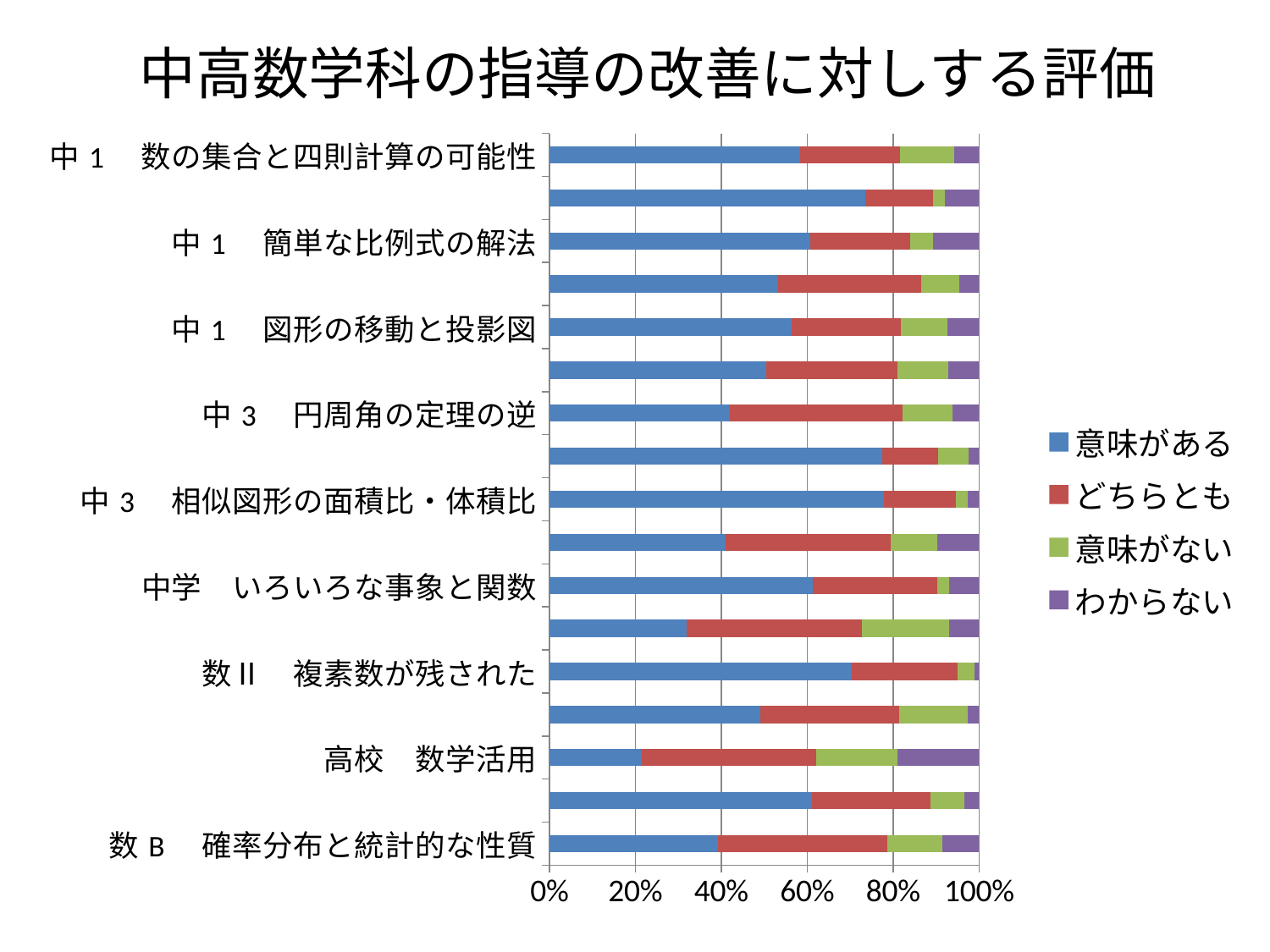
How many bars are plotted in the chart? 17 Is the 意味がある value for 中3 相似図形の面積比・体積比 greater or less than 60%? greater Is the 意味がある value for 高校 数学活用 greater or less than 40%? less Which category has the smallest 意味がある share? 高校 数学活用 Which legend entry is shown in blue? 意味がある What kind of chart is shown on the slide? stacked bar chart Which has the larger 意味がある share: 高校 数学活用 or 数Ⅱ 複素数が残された? 数Ⅱ 複素数が残された What is the title of the chart? 中高数学科の指導の改善に対する評価 Is the 意味がある value for 中1 数の集合と四則計算の可能性 greater or less than 40%? greater How many series does the legend list? 4